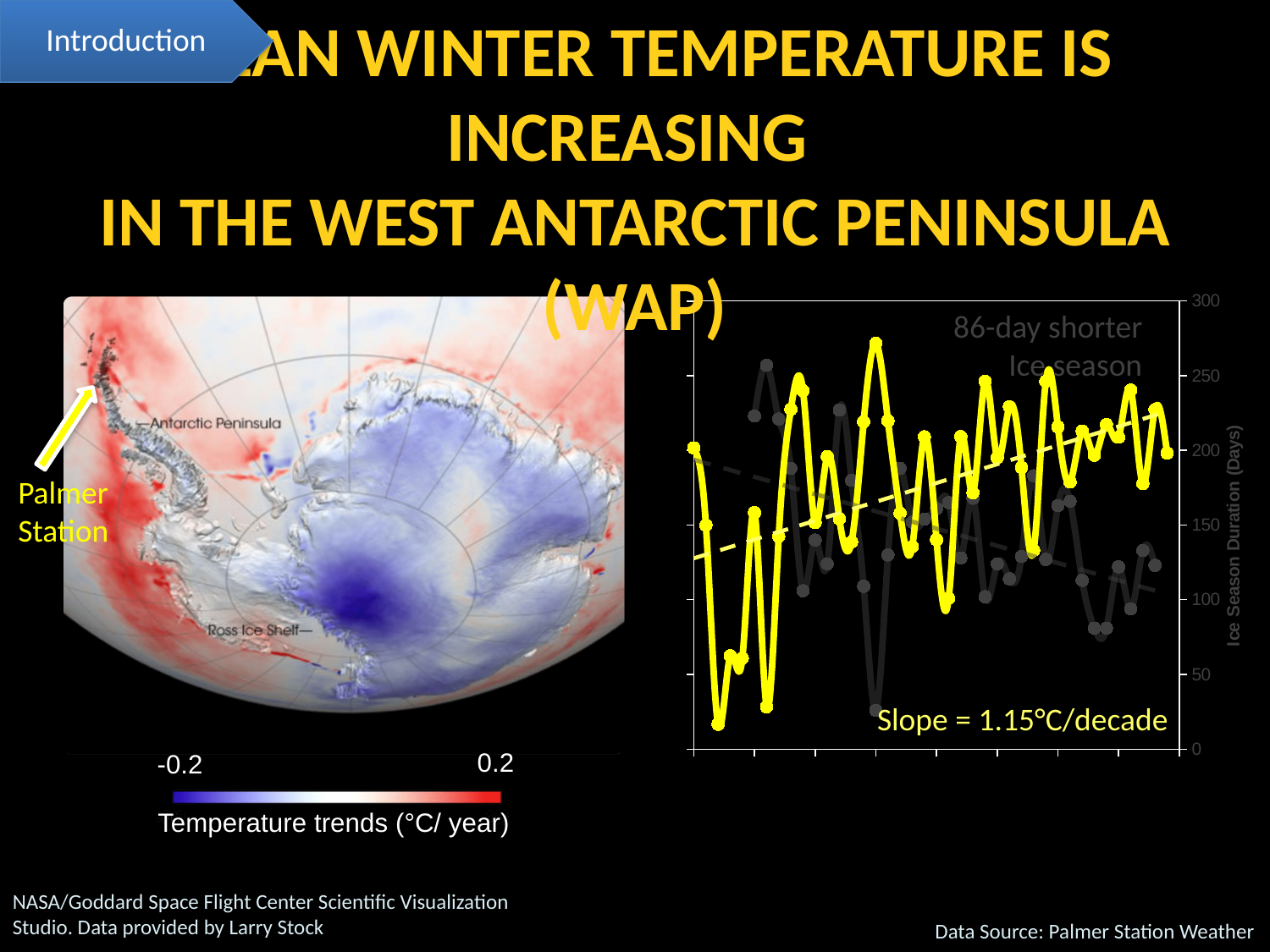
What kind of chart is shown on the right side of the slide? line chart In the chart on the right, does the gray line's dashed trend rise or fall from left to right? fall What is the highest tick value shown on the right-hand vertical axis of the chart on the right? 300 What slope is stated on the chart on the right? 1.15°C/decade How many line series are plotted in the chart on the right? 2 What is the label of the right-hand vertical axis of the chart on the right? Ice Season Duration (Days) According to the annotation on the chart on the right, by how many days is the ice season shorter? 86-day shorter In the chart on the right, does the yellow line's dashed trend rise or fall from left to right? rise